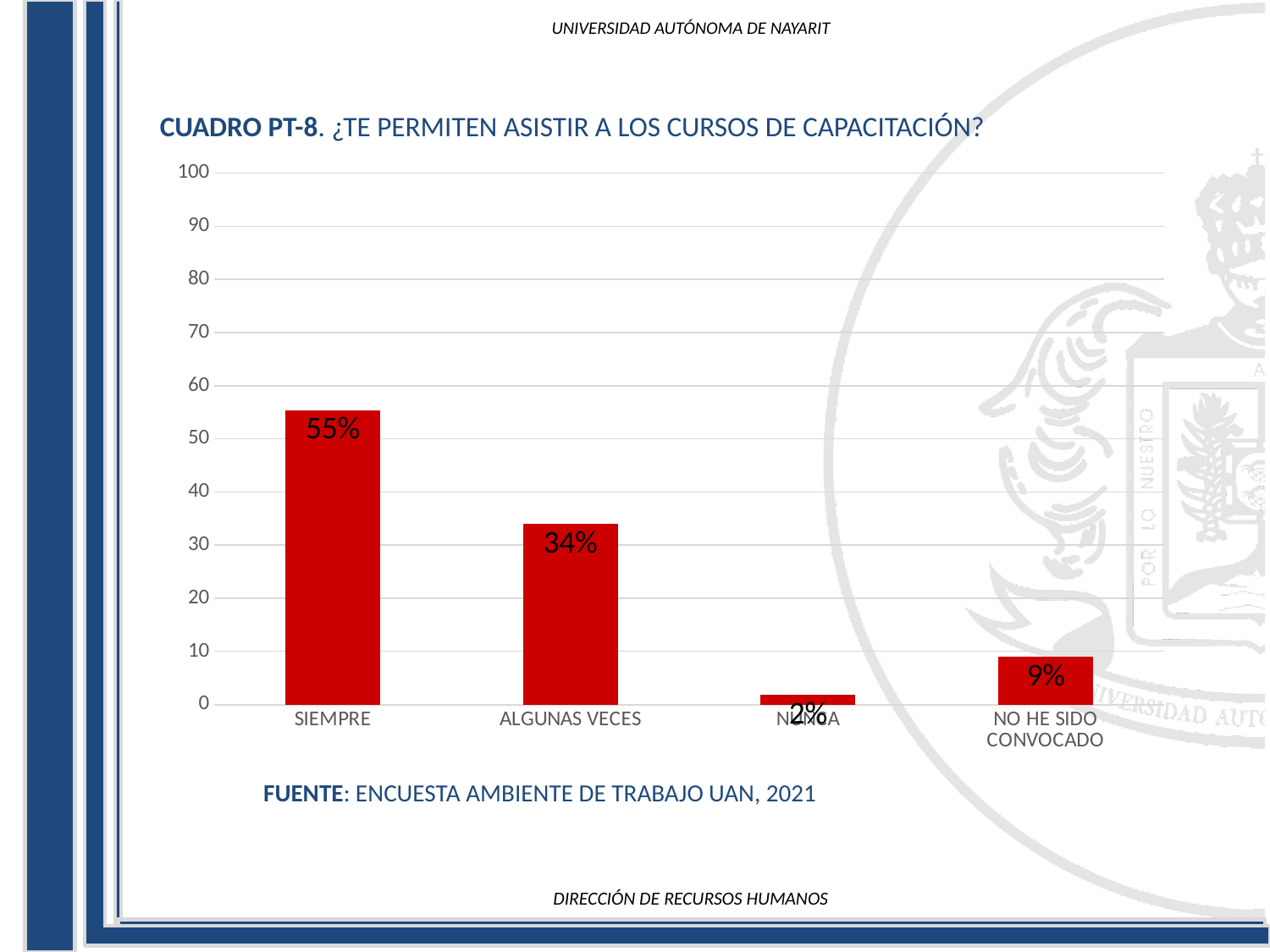
What is the value for NO HE SIDO CONVOCADO? 9% What kind of chart is shown on the slide? bar chart How many categories are shown on the x axis? 4 Which category has the highest value? SIEMPRE What is the value for ALGUNAS VECES? 34% What is the difference between the values for SIEMPRE and ALGUNAS VECES? 21% What is the value of the third bar from the left? 2% What is the value for SIEMPRE? 55% Is the value for SIEMPRE greater or less than 50? greater What is the source cited below the chart? ENCUESTA AMBIENTE DE TRABAJO UAN, 2021 What is the difference between the values for ALGUNAS VECES and NO HE SIDO CONVOCADO? 25% Which is larger, the value for ALGUNAS VECES or the value for NO HE SIDO CONVOCADO? ALGUNAS VECES